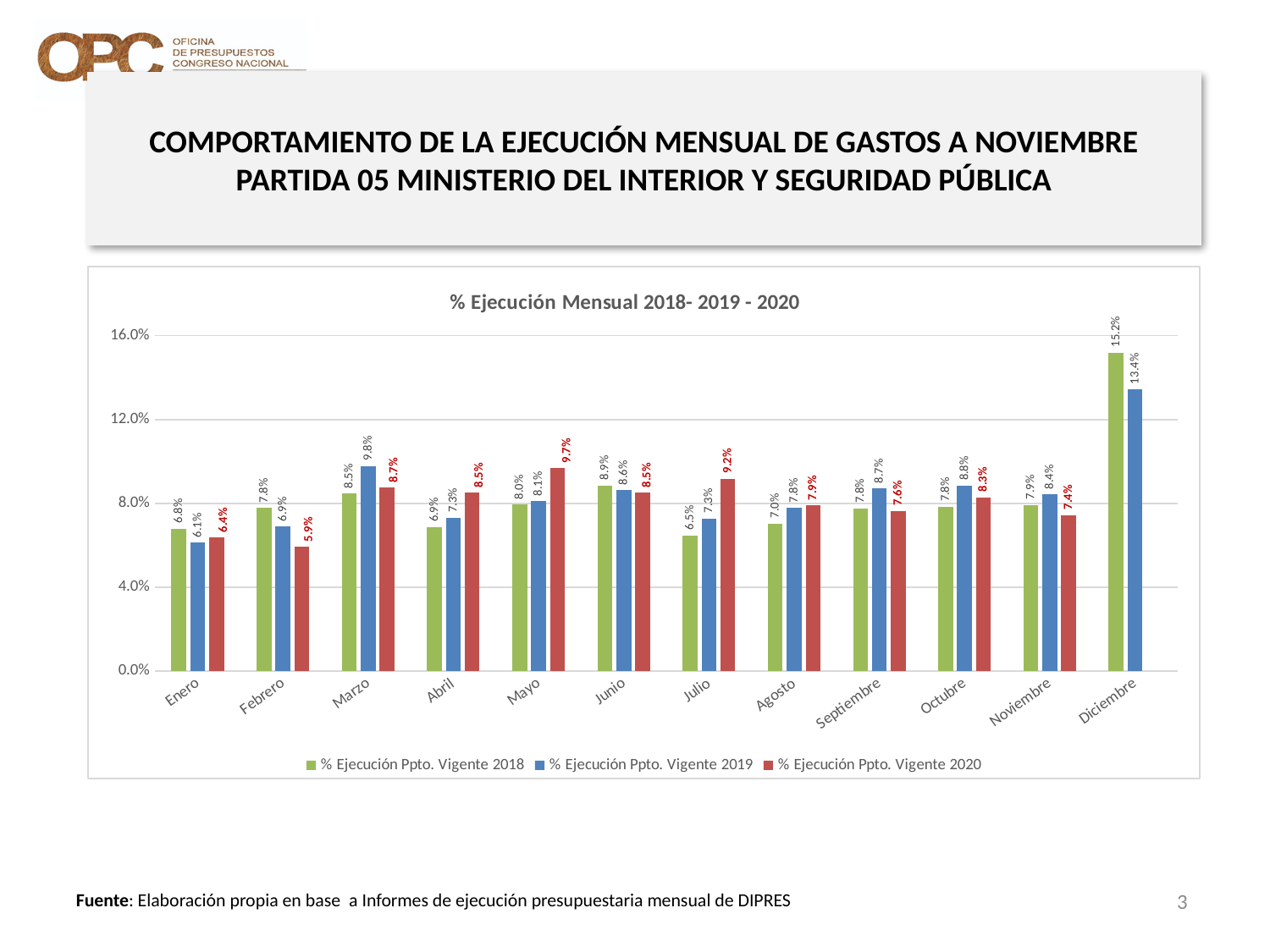
What is the value for % Ejecución Ppto. Vigente 2018 in Diciembre? 15.2% How many series does the legend list? 3 Is the value for % Ejecución Ppto. Vigente 2019 in Diciembre greater or less than 12.0%? greater Which month has the lowest value for % Ejecución Ppto. Vigente 2020? Febrero In Julio, which series has the larger value: % Ejecución Ppto. Vigente 2018 or % Ejecución Ppto. Vigente 2020? % Ejecución Ppto. Vigente 2020 What is the difference between the 2018 and 2019 values in Diciembre? 1.8% How many months are shown on the x axis? 12 Which month has the highest value for % Ejecución Ppto. Vigente 2019? Diciembre What is the title of the chart? % Ejecución Mensual 2018- 2019 - 2020 What kind of chart is shown on the slide? Bar chart What is the value for % Ejecución Ppto. Vigente 2019 in Marzo? 9.8% What is the value for % Ejecución Ppto. Vigente 2020 in Mayo? 9.7%